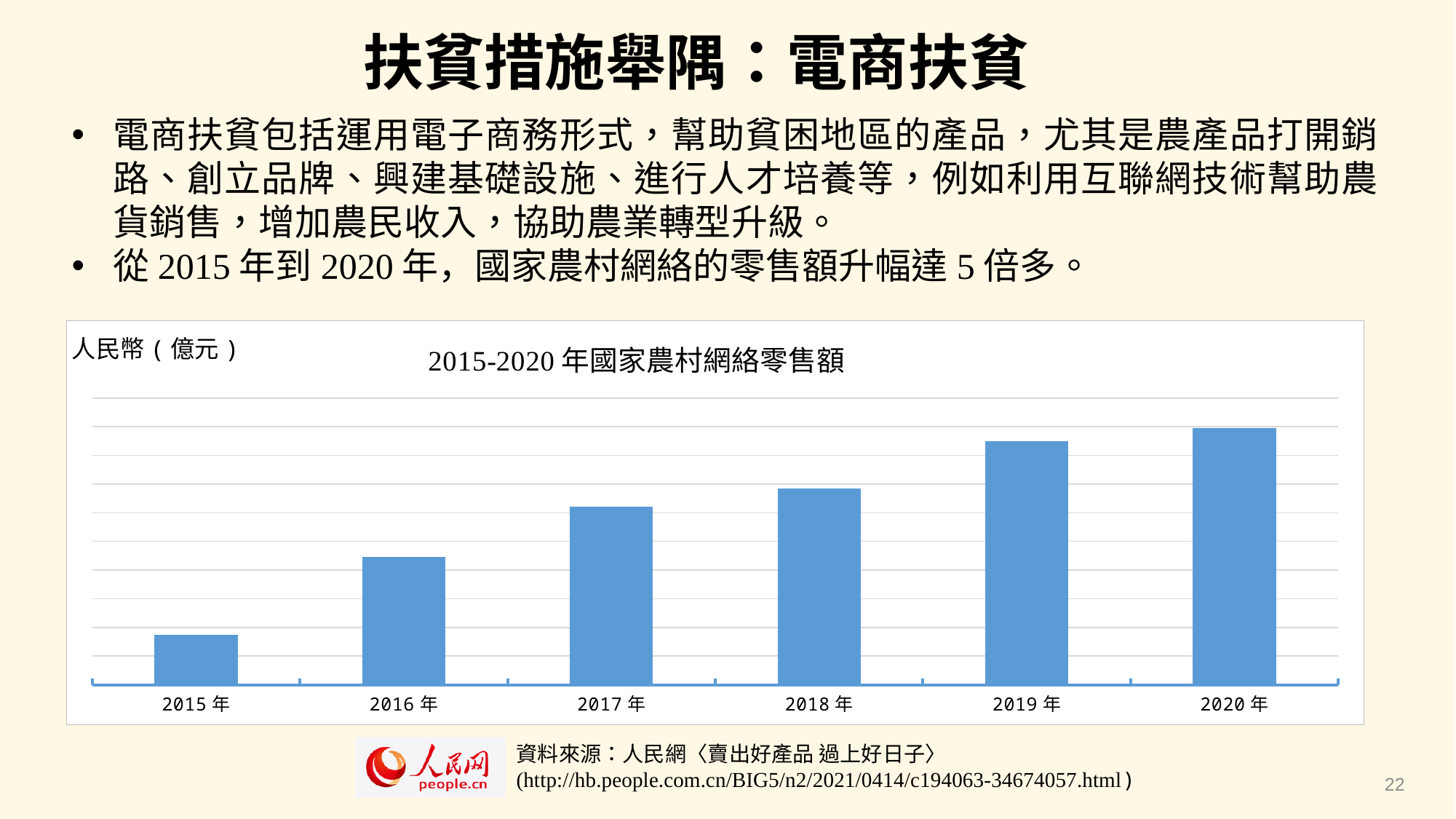
Which year has the lowest bar in the chart? 2015 年 How many years (bars) are plotted in the chart? 6 Which is larger, the value for 2017 年 or the value for 2015 年? 2017 年 What unit label is shown at the top left of the chart? 人民幣（億元） Which is larger, the value for 2019 年 or the value for 2016 年? 2019 年 What is the title of the chart? 2015-2020 年國家農村網絡零售額 Do the values rise or fall from 2015 年 to 2020 年? Rise What is the first year shown on the x axis of the chart? 2015 年 Which year has the highest bar in the chart? 2020 年 Which is larger, the value for 2016 年 or the value for 2018 年? 2018 年 What type of chart is shown on the slide? Bar chart